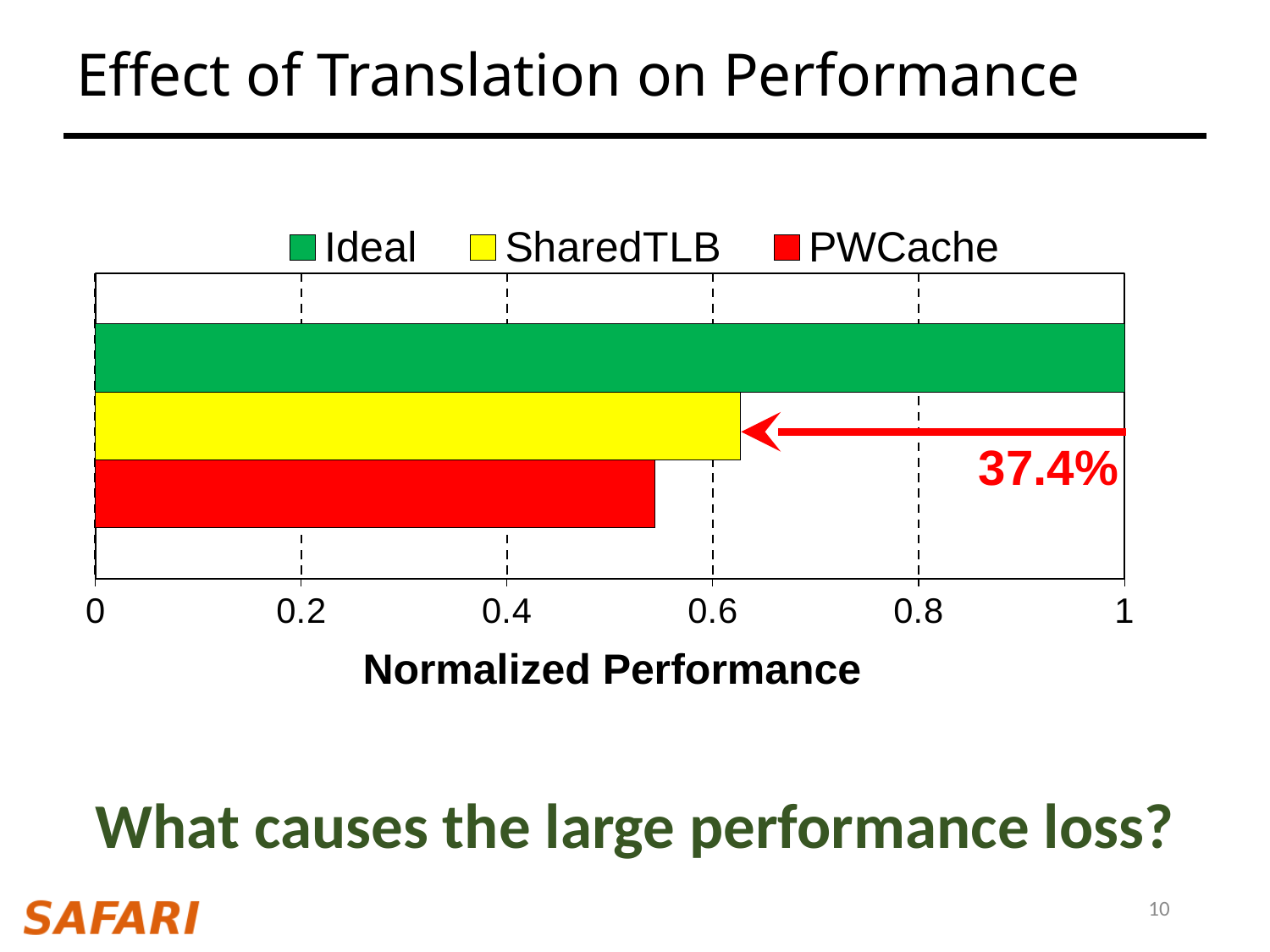
Which series has the lowest normalized performance? PWCache What percentage is printed in red next to the arrow on the chart? 37.4% How many series does the legend list? 3 Which has a larger normalized performance, SharedTLB or PWCache? SharedTLB Which series has the highest normalized performance? Ideal What kind of chart is shown on the slide? bar chart What is the label of the x axis? Normalized Performance Is the value for PWCache greater or less than 0.4? greater Is the value for PWCache greater or less than 0.6? less What is the normalized performance value for Ideal? 1 Is the value for SharedTLB greater or less than 0.6? greater How many bars are plotted in the chart? 3